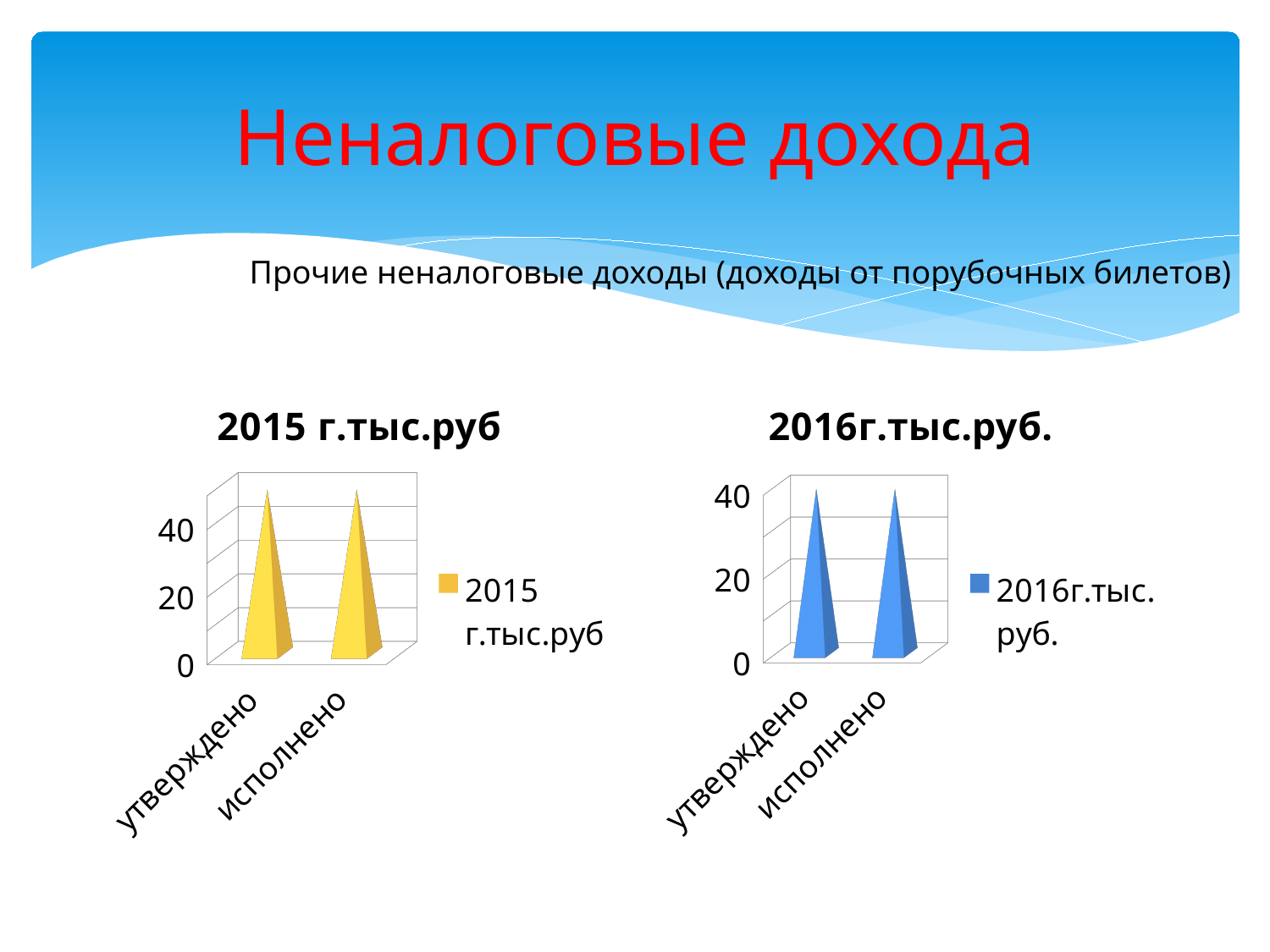
In the chart titled "2015 г.тыс.руб", how many series does the legend list? 1 What kind of chart is the chart titled "2015 г.тыс.руб"? bar chart In the chart titled "2015 г.тыс.руб", is the value for утверждено greater or less than 40? greater In the chart titled "2015 г.тыс.руб", is the value for исполнено greater or less than 20? greater In the chart titled "2016г.тыс.руб.", is the value for исполнено greater or less than 20? greater What is the legend entry in the chart on the right of the slide? 2016г.тыс.руб. In the chart titled "2016г.тыс.руб.", how many categories are shown on the x axis? 2 In the chart titled "2015 г.тыс.руб", how many categories are shown on the x axis? 2 In the chart titled "2016г.тыс.руб.", how many series does the legend list? 1 What colour are the bars in the chart titled "2015 г.тыс.руб"? yellow